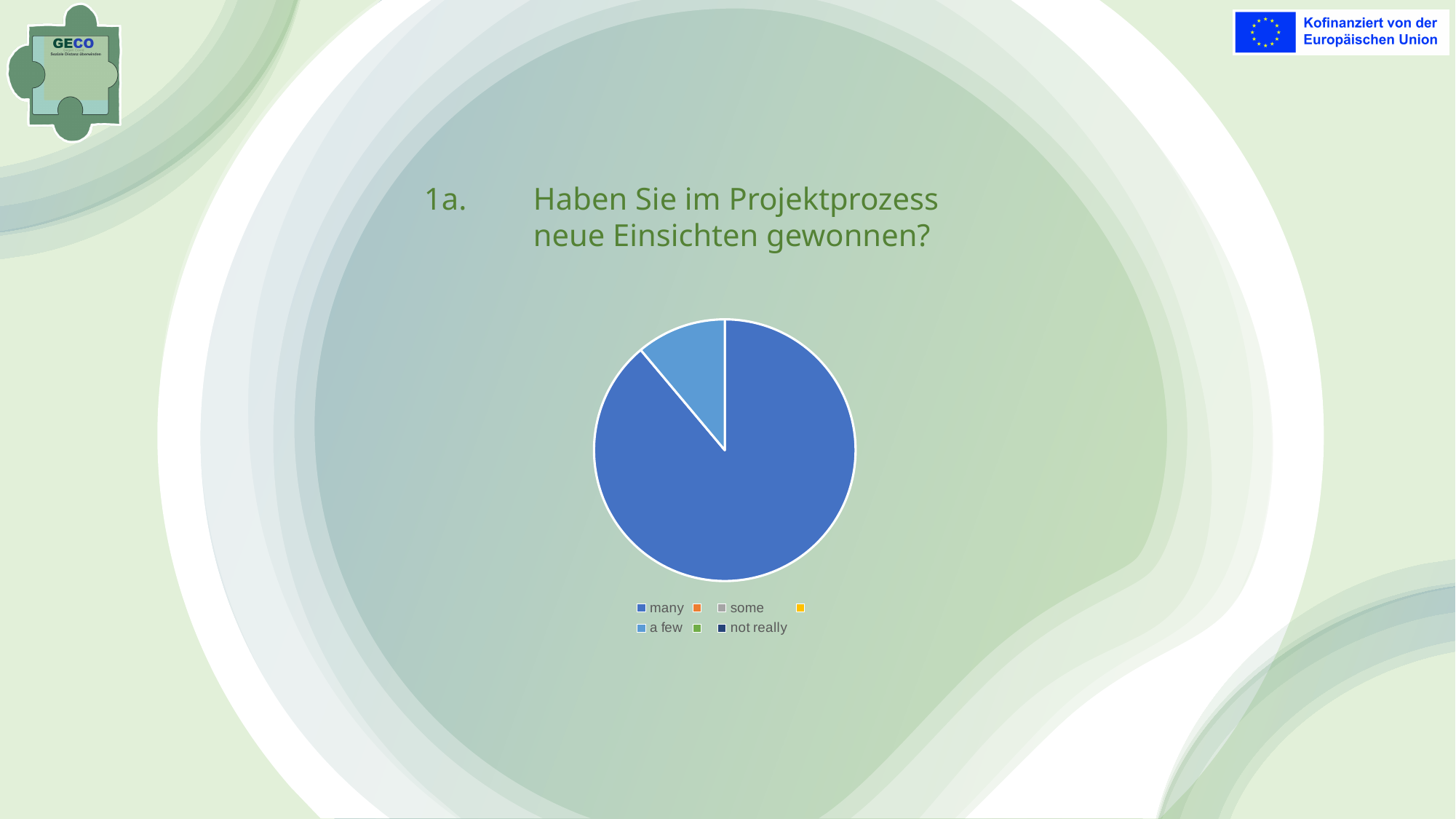
Which category has the largest slice of the pie? many What kind of chart is shown on the slide? pie chart How many slices are visible in the pie chart? 2 Which legend entry corresponds to the light blue slice of the pie? a few What is the title of the chart on the slide? 1a. Haben Sie im Projektprozess neue Einsichten gewonnen? Of the slices visible in the pie, which category has the smallest slice? a few Which slice is larger, "many" or "a few"? many